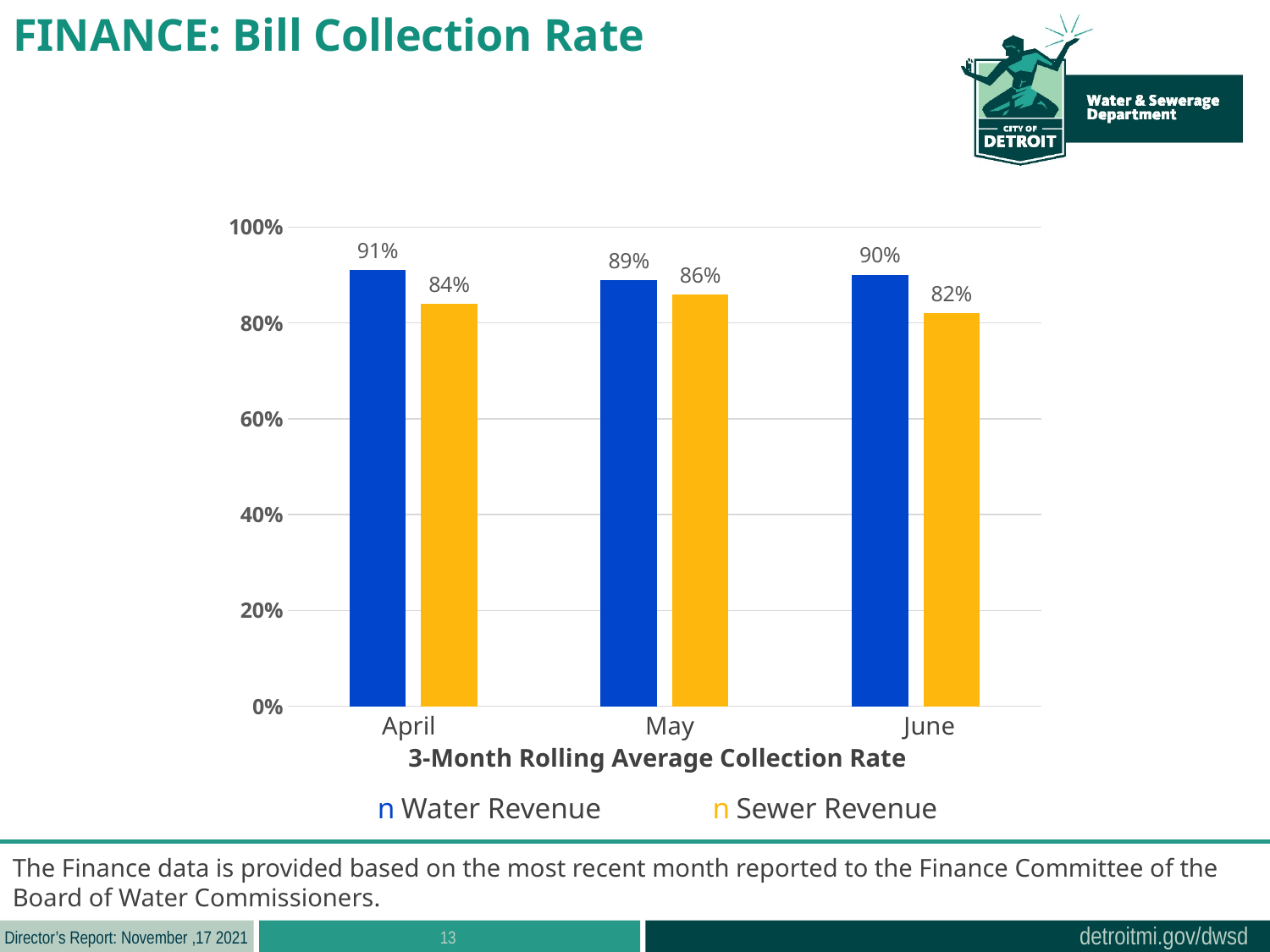
How many series does the legend list? 2 What is the Sewer Revenue collection rate for June? 82% Which is larger in April, the Water Revenue or the Sewer Revenue collection rate? Water Revenue What kind of chart is shown on the slide? Bar chart What is the Water Revenue collection rate for April? 91% Is the Sewer Revenue collection rate for June greater or less than 80%? greater Which month has the highest Sewer Revenue collection rate? May Which month has the lowest Water Revenue collection rate? May What is the x-axis title of the chart? 3-Month Rolling Average Collection Rate What is the Sewer Revenue collection rate for May? 86% What is the difference between the Water Revenue and Sewer Revenue collection rates in June? 8% How many months are shown on the x axis? 3